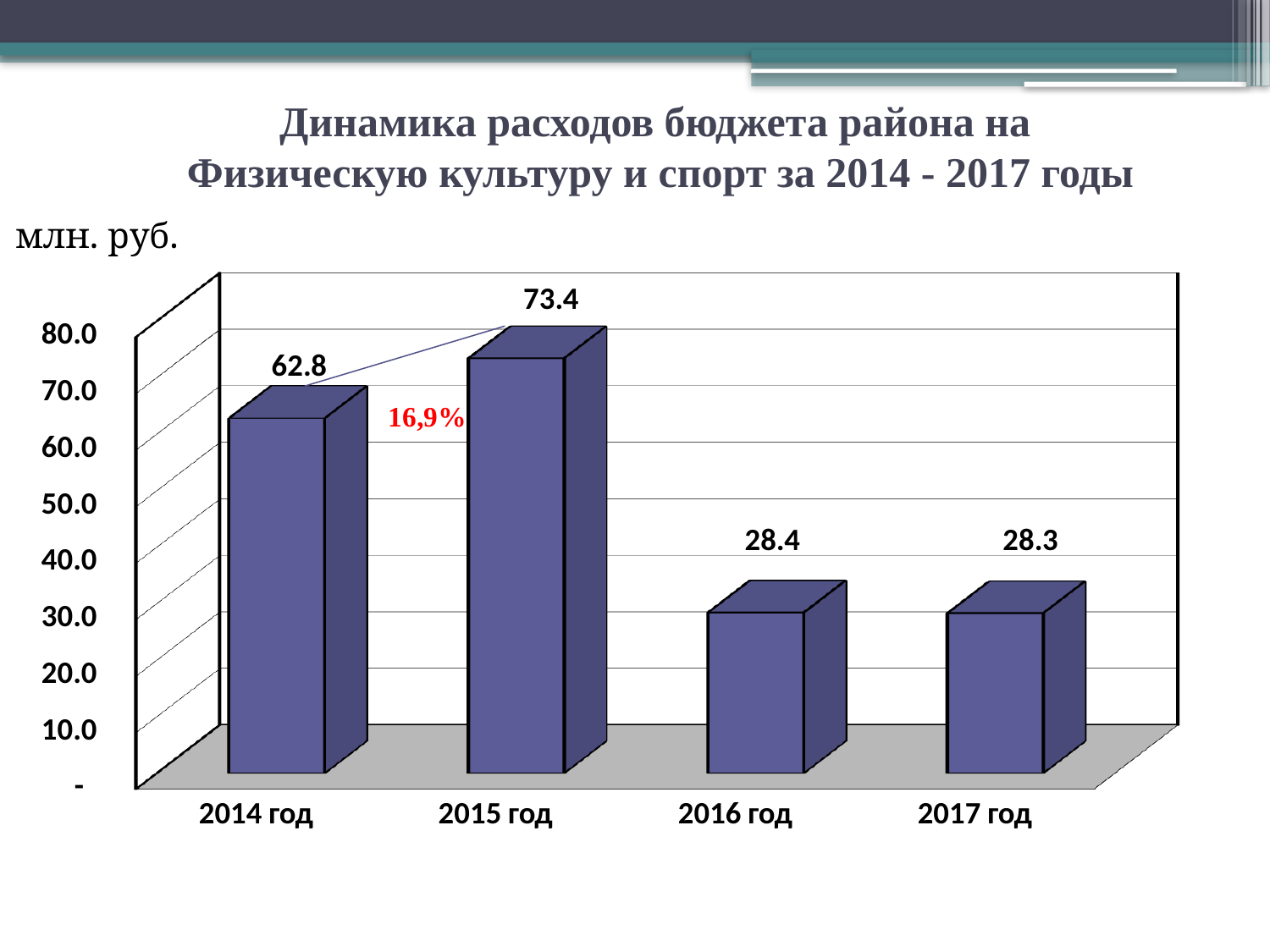
What kind of chart is this? bar chart What is the value for 2015 год? 73.4 What is the value for 2017 год? 28.3 What unit is indicated above the chart? млн. руб. What percentage change is annotated in red between 2014 год and 2015 год? 16,9% What is the value for 2016 год? 28.4 What is the value for 2014 год? 62.8 What is the difference between the values for 2014 год and 2016 год? 34.4 Which year has the highest value? 2015 год What is the difference between the values for 2015 год and 2014 год? 10.6 Which is larger, the value for 2014 год or the value for 2015 год? 2015 год How many years are shown on the x axis? 4